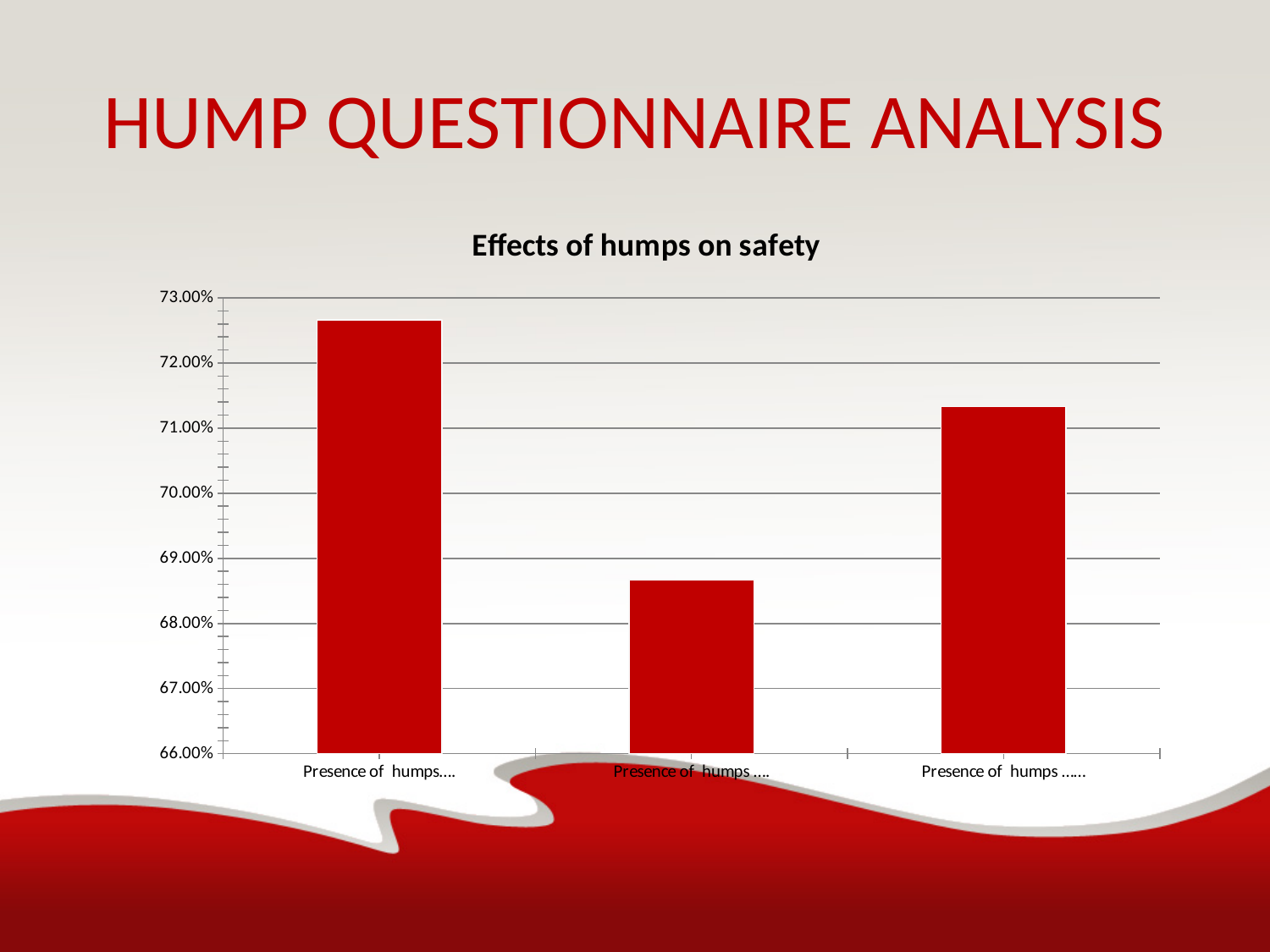
Which bar is the lowest: the left, middle or right one? middle Which is larger, the value of the left bar or the value of the right bar? left bar Is the value of the right bar greater or less than 71.00%? greater What is the title of the chart? Effects of humps on safety Does the value fall or rise from the left bar to the middle bar? fall What colour are the bars in the chart? red Which bar is the highest: the left, middle or right one? left How many bars are plotted in the chart? 3 What kind of chart is shown on the slide? bar chart Is the value of the left bar greater or less than 72.00%? greater Is the value of the middle bar greater or less than 68.00%? greater